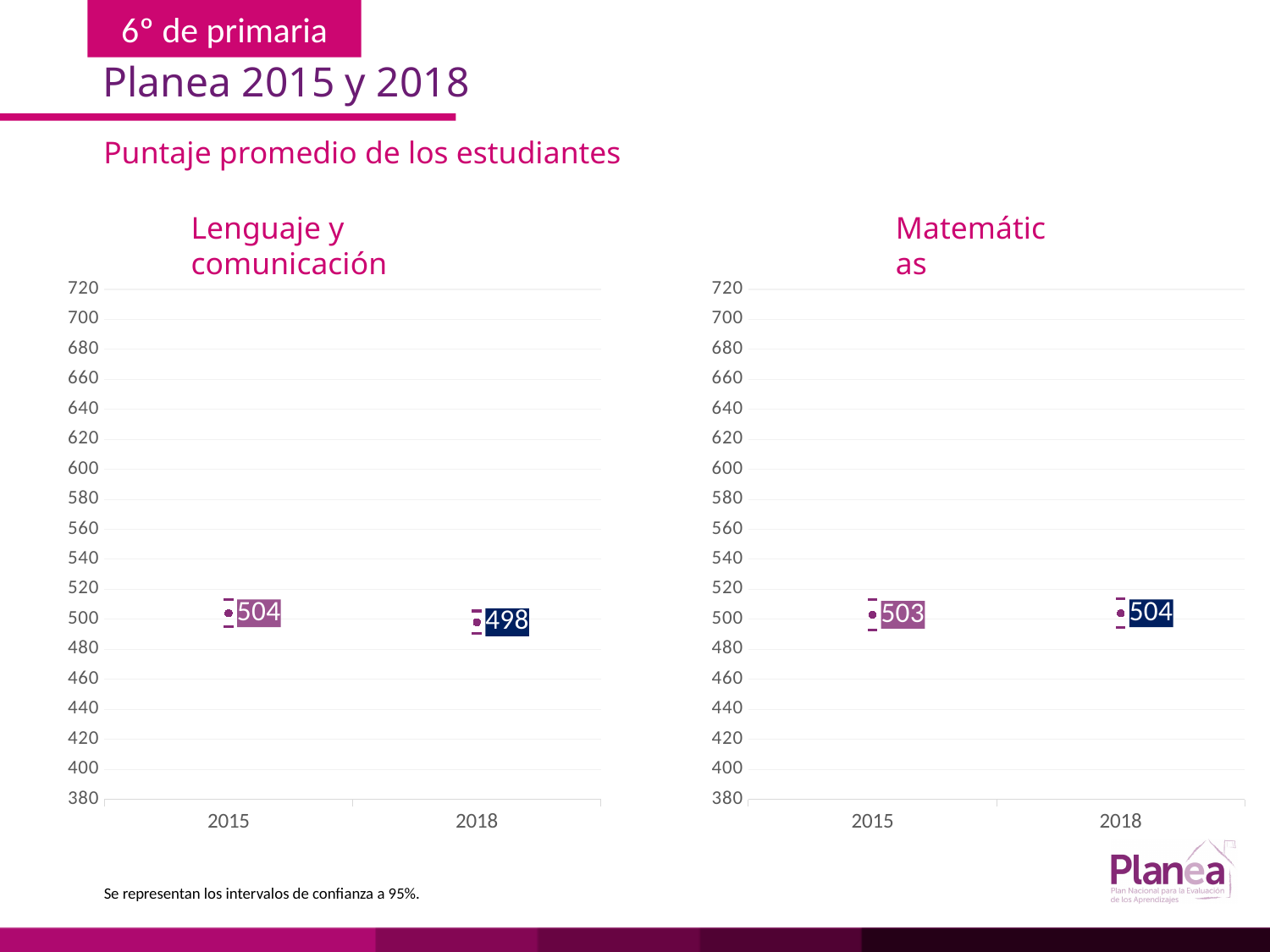
In the 'Matemáticas' chart, what is the difference between the 2018 and 2015 scores? 1 In the 'Lenguaje y comunicación' chart, by how many points did the score change from 2015 to 2018? 6 In the 'Lenguaje y comunicación' chart, is the 2018 value greater or less than 500? less In the 'Lenguaje y comunicación' chart, what is the average score for 2015? 504 What is the highest value shown on the vertical axis of the 'Matemáticas' chart? 720 How many years are plotted in the 'Matemáticas' chart? 2 In the 'Matemáticas' chart, what is the average score for 2015? 503 In the 'Matemáticas' chart, what is the average score for 2018? 504 In the 'Lenguaje y comunicación' chart, what is the average score for 2018? 498 In the 'Lenguaje y comunicación' chart, which year has the higher score, 2015 or 2018? 2015 In the 'Lenguaje y comunicación' chart, does the score rise or fall from 2015 to 2018? fall In the 'Matemáticas' chart, does the score rise or fall from 2015 to 2018? rise